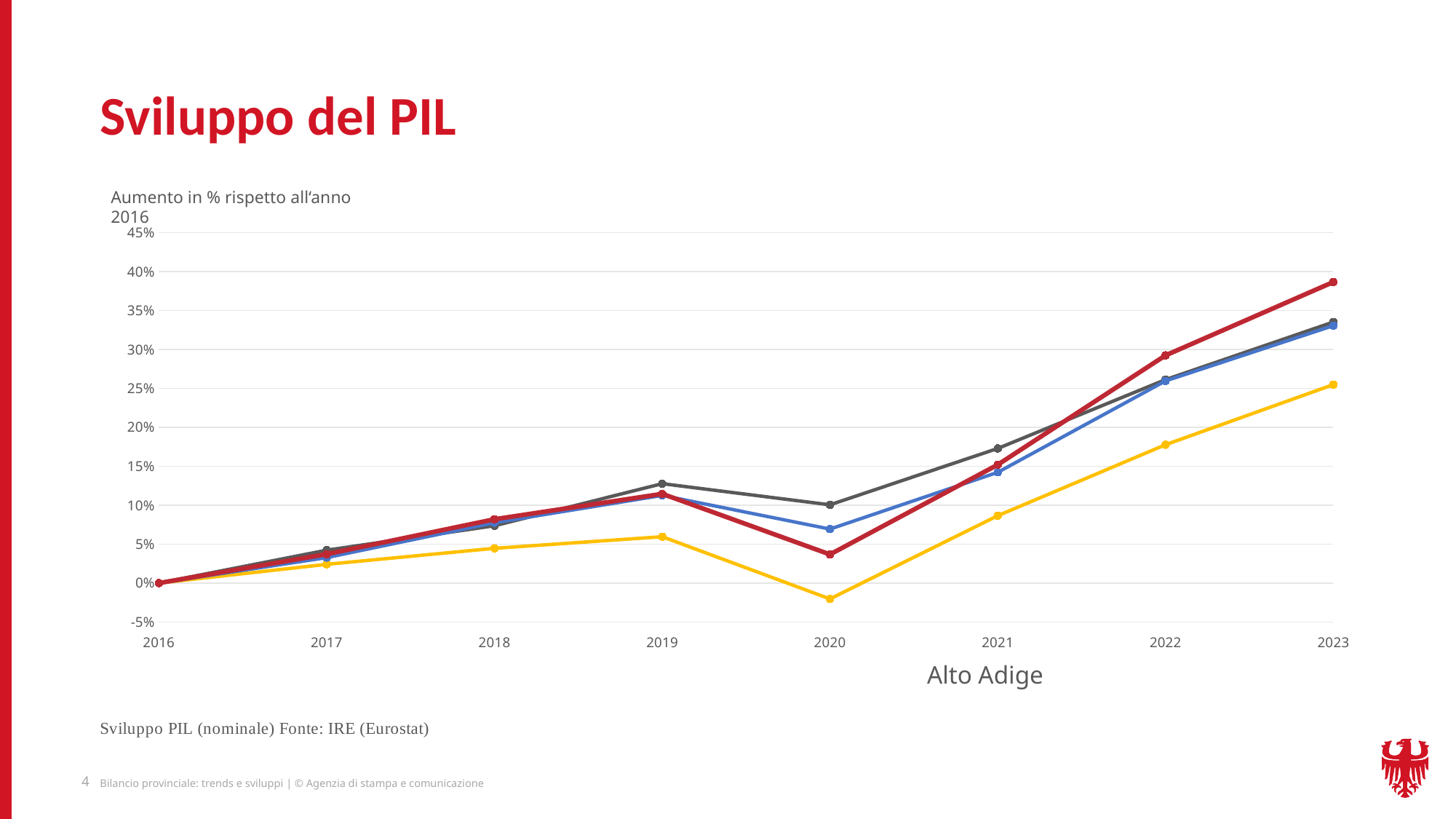
What is the title of the slide? Sviluppo del PIL In 2020, which line is higher, the dark grey line or the yellow line? the dark grey line Is the value of the yellow line in 2020 greater or less than 0%? less In which year does the yellow line reach its lowest value? 2020 From 2020 to 2023, do the values of the lines rise or fall? rise Is the value of the red line in 2020 greater or less than 10%? less What kind of chart is shown on the slide? line chart Is the value of the red line in 2023 greater or less than 35%? greater In 2023, which line is higher, the red line or the yellow line? the red line In which year does the red line reach its highest value? 2023 How many years are plotted along the x axis? 8